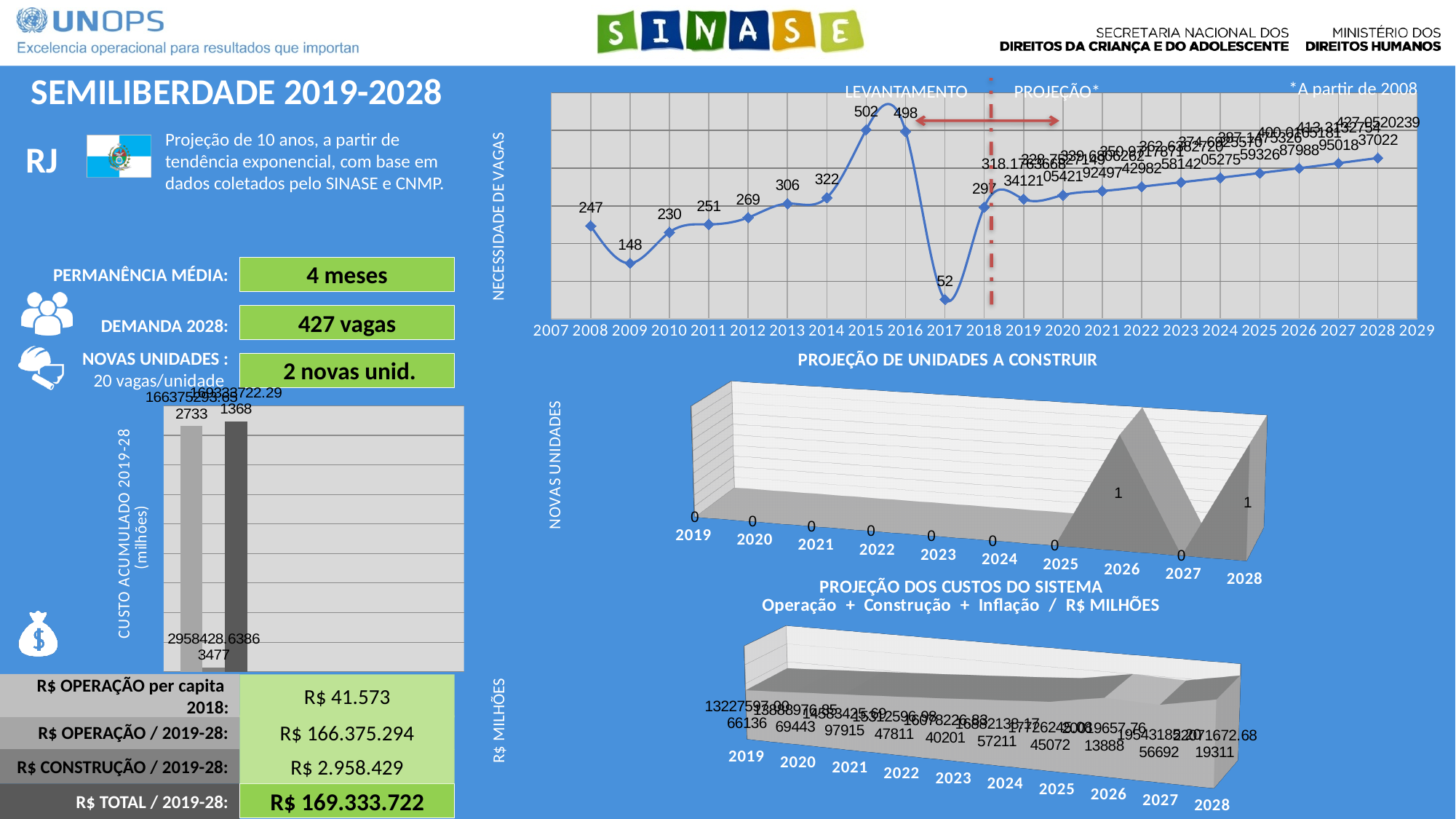
In the line chart of NECESSIDADE DE VAGAS, which year in the LEVANTAMENTO period (2008-2018) has the lowest value? 2017 In the line chart of NECESSIDADE DE VAGAS, what is the difference between the values for 2018 and 2017? 245 In the line chart of NECESSIDADE DE VAGAS, what is the value for 2017? 52 In the chart PROJEÇÃO DE UNIDADES A CONSTRUIR, what is the value for 2026? 1 In the line chart of NECESSIDADE DE VAGAS, is the value for 2013 larger than the value for 2010? Yes, 2013 (306) In the line chart of NECESSIDADE DE VAGAS, do the values rise or fall from 2019 to 2028 in the PROJEÇÃO period? Rise In the line chart of NECESSIDADE DE VAGAS, what is the value for 2015? 502 In the line chart of NECESSIDADE DE VAGAS, what is the difference between the values for 2015 and 2016? 4 In the line chart of NECESSIDADE DE VAGAS, what is the value for 2008? 247 In the line chart of NECESSIDADE DE VAGAS, which year in the LEVANTAMENTO period (2008-2018) has the highest value? 2015 In the chart PROJEÇÃO DE UNIDADES A CONSTRUIR, what is the value for 2027? 0 How many years are shown on the x axis of the chart PROJEÇÃO DE UNIDADES A CONSTRUIR? 10